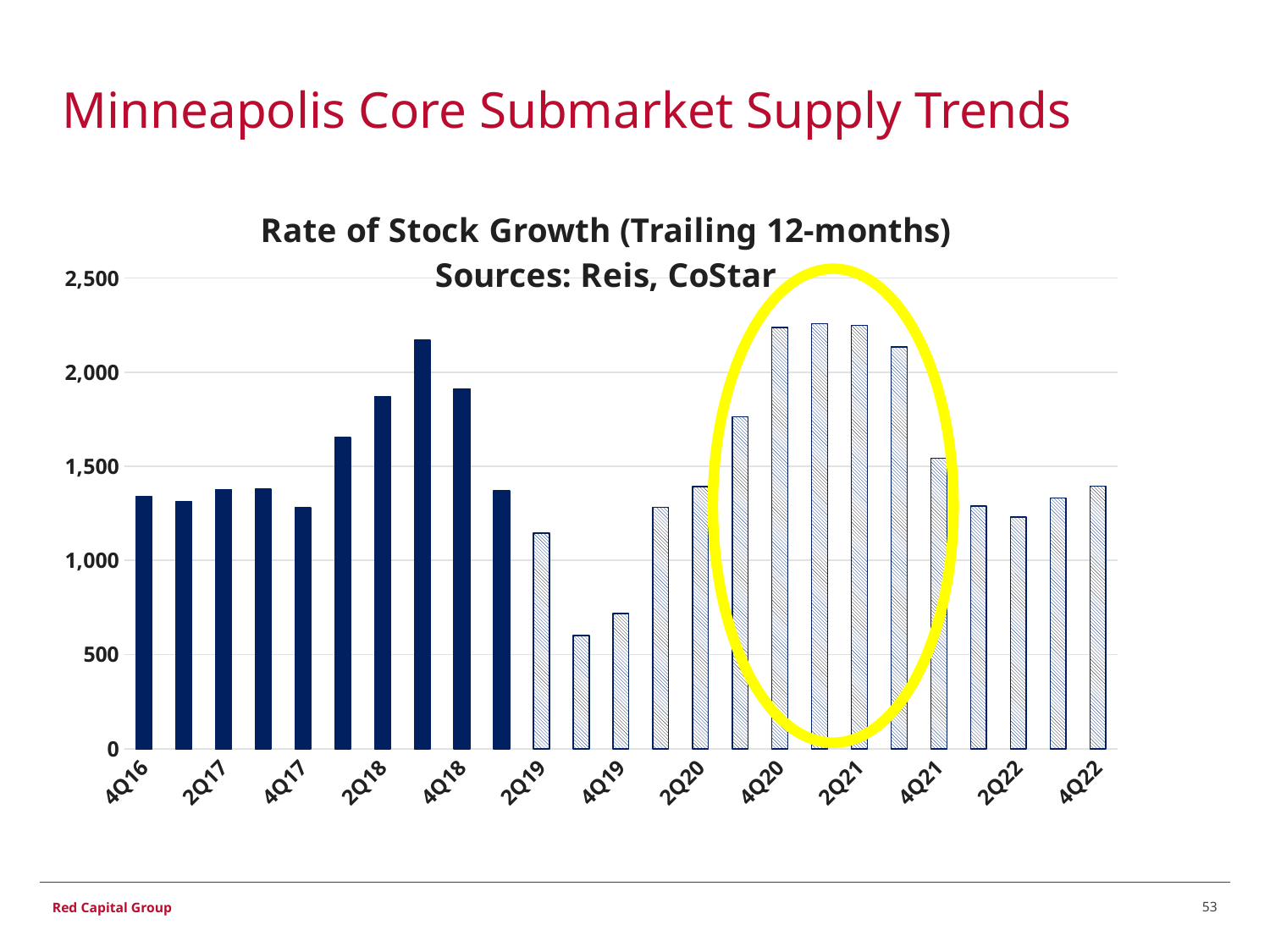
Which is larger, the value for 4Q20 or the value for 4Q16? 4Q20 Which is larger, the value for 4Q19 or the value for 4Q22? 4Q22 Is the value for 2Q22 greater or less than 1,500? less Do the values rise or fall from 4Q19 to 2Q21? Rise Is the value for 4Q19 greater or less than 1,000? less Do the values rise or fall from 2Q21 to 2Q22? Fall Is the value for 4Q16 greater or less than 1,000? greater What kind of chart is shown on the slide? Bar chart What is the title of the chart? Rate of Stock Growth (Trailing 12-months) What sources are cited under the chart title? Reis, CoStar